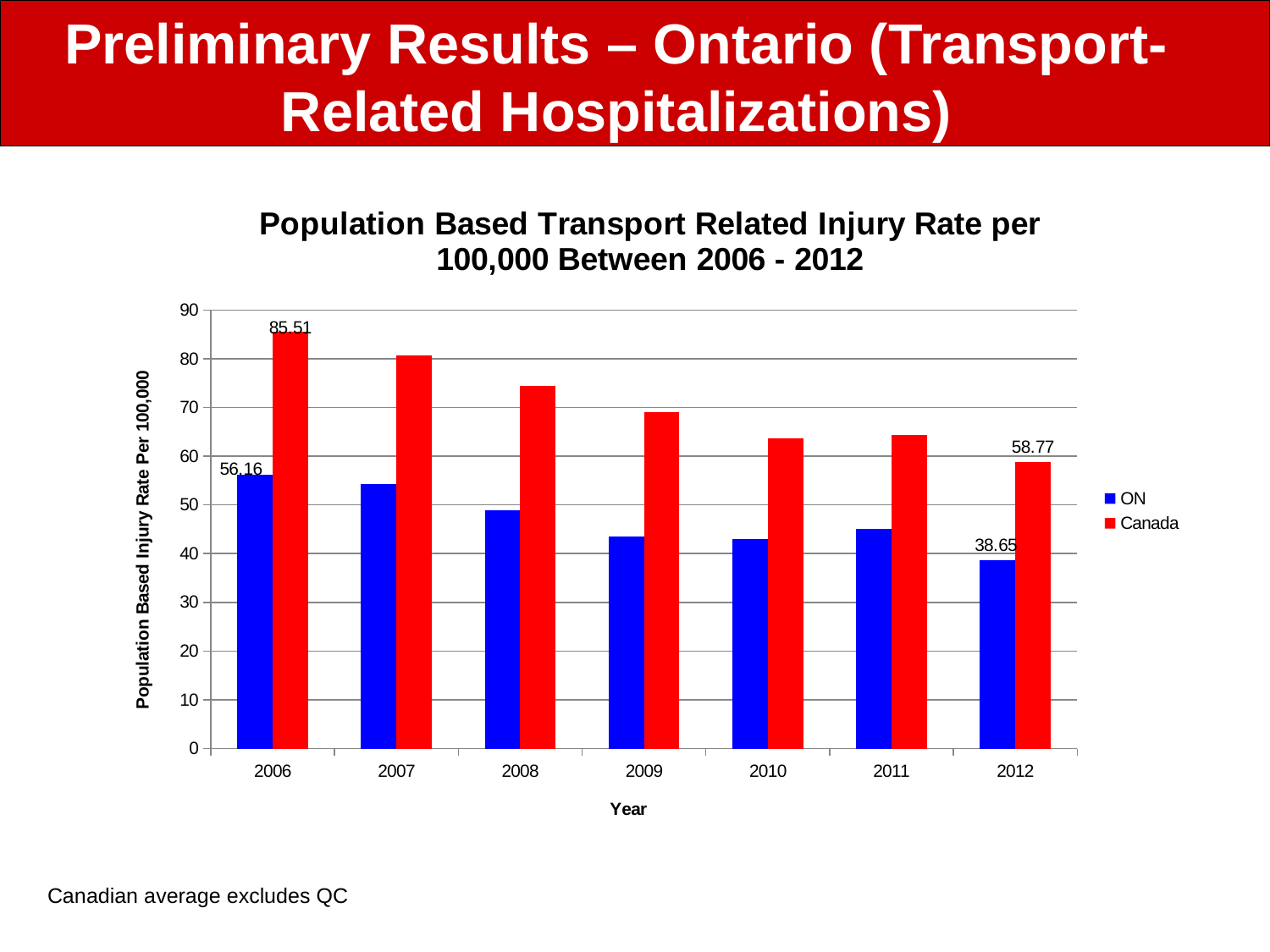
Which year has the lowest value for ON? 2012 What kind of chart is shown on the slide? Bar chart Which is larger in 2009, the value for ON or the value for Canada? Canada What is the difference between the Canada and ON values in 2006? 29.35 What is the value for ON in 2012? 38.65 How many series does the legend list? 2 What is the difference between the Canada and ON values in 2012? 20.12 What is the value for Canada in 2006? 85.51 What is the value for Canada in 2012? 58.77 Which year has the highest value for Canada? 2006 What is the value for ON in 2006? 56.16